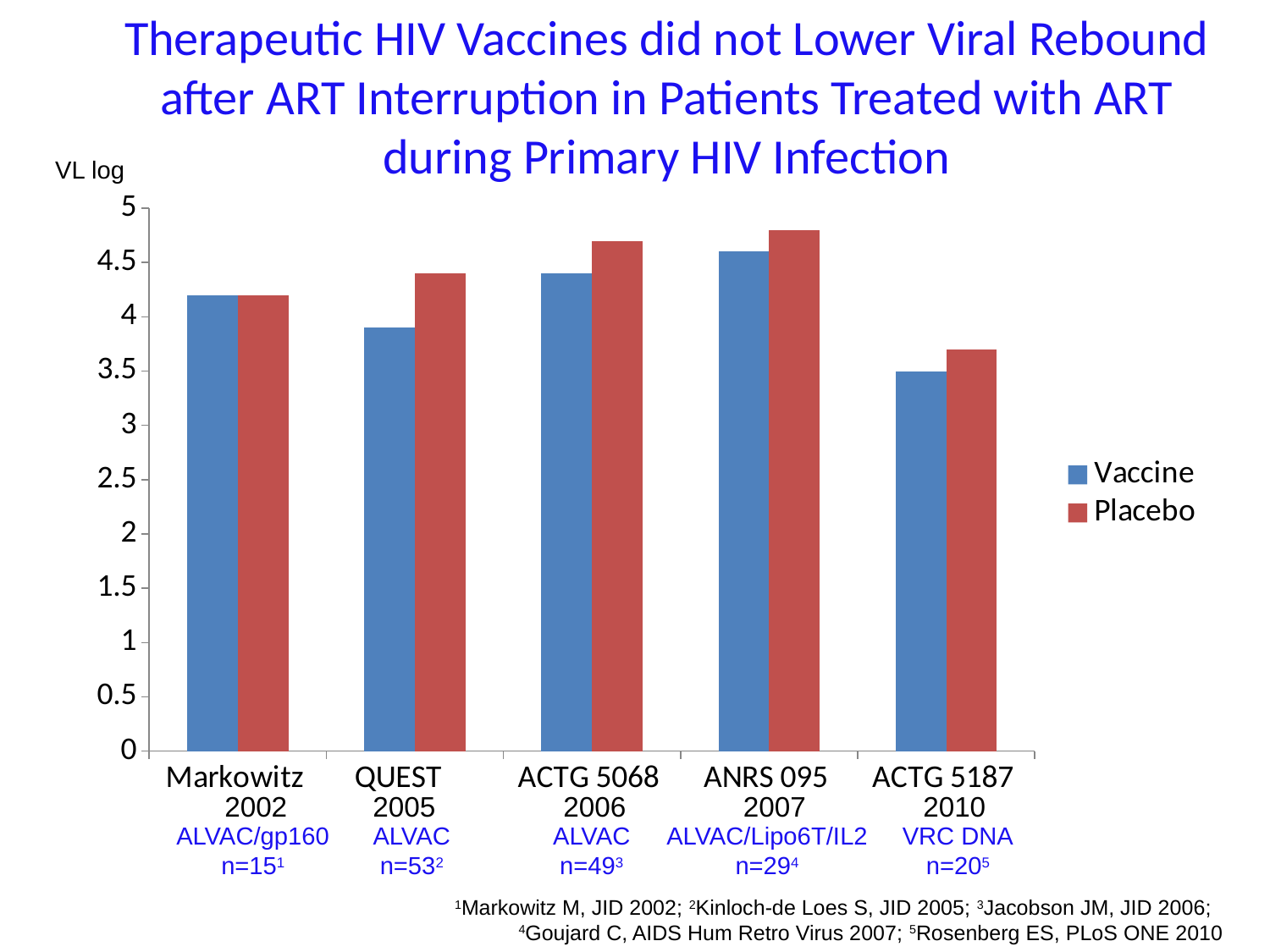
What kind of chart is shown on the slide? bar chart Is the Placebo value for ACTG 5068 2006 greater or less than 4.5? greater Which study has the lowest Placebo value? ACTG 5187 2010 Is the Vaccine value for QUEST 2005 greater or less than 4? less Which study has the lowest Vaccine value? ACTG 5187 2010 How many studies (categories) are shown on the x axis? 5 What label is shown on the y axis of the chart? VL log Is the Placebo value for ACTG 5187 2010 greater or less than 4? less How many series does the legend list? 2 Which study has the highest Vaccine value? ANRS 095 2007 For QUEST 2005, which is larger, the Vaccine value or the Placebo value? Placebo